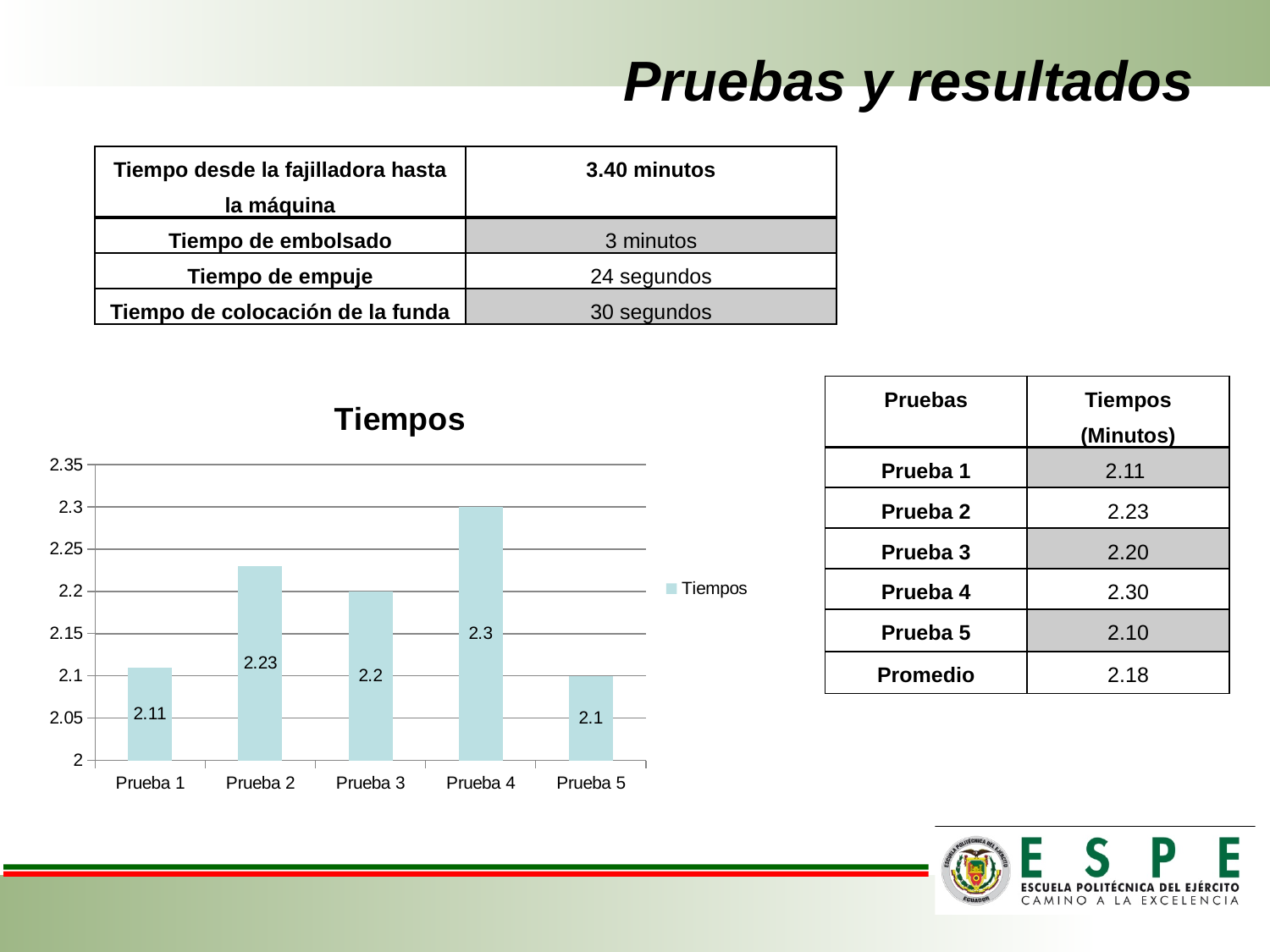
What is the value for Prueba 1 in the Tiempos chart? 2.11 What kind of chart is the Tiempos chart? bar chart What is the value for Prueba 5 in the Tiempos chart? 2.1 Which category has the lowest value in the Tiempos chart? Prueba 5 Which category has the highest value in the Tiempos chart? Prueba 4 How many categories are shown in the Tiempos chart? 5 Is the value for Prueba 4 in the Tiempos chart greater or less than 2.25? greater What is the value for Prueba 4 in the Tiempos chart? 2.3 How many series does the legend of the Tiempos chart list? 1 What is the difference between the values for Prueba 2 and Prueba 3 in the Tiempos chart? 0.03 What is the difference between the values for Prueba 4 and Prueba 1 in the Tiempos chart? 0.19 In the Tiempos chart, which is larger, the value for Prueba 2 or the value for Prueba 3? Prueba 2